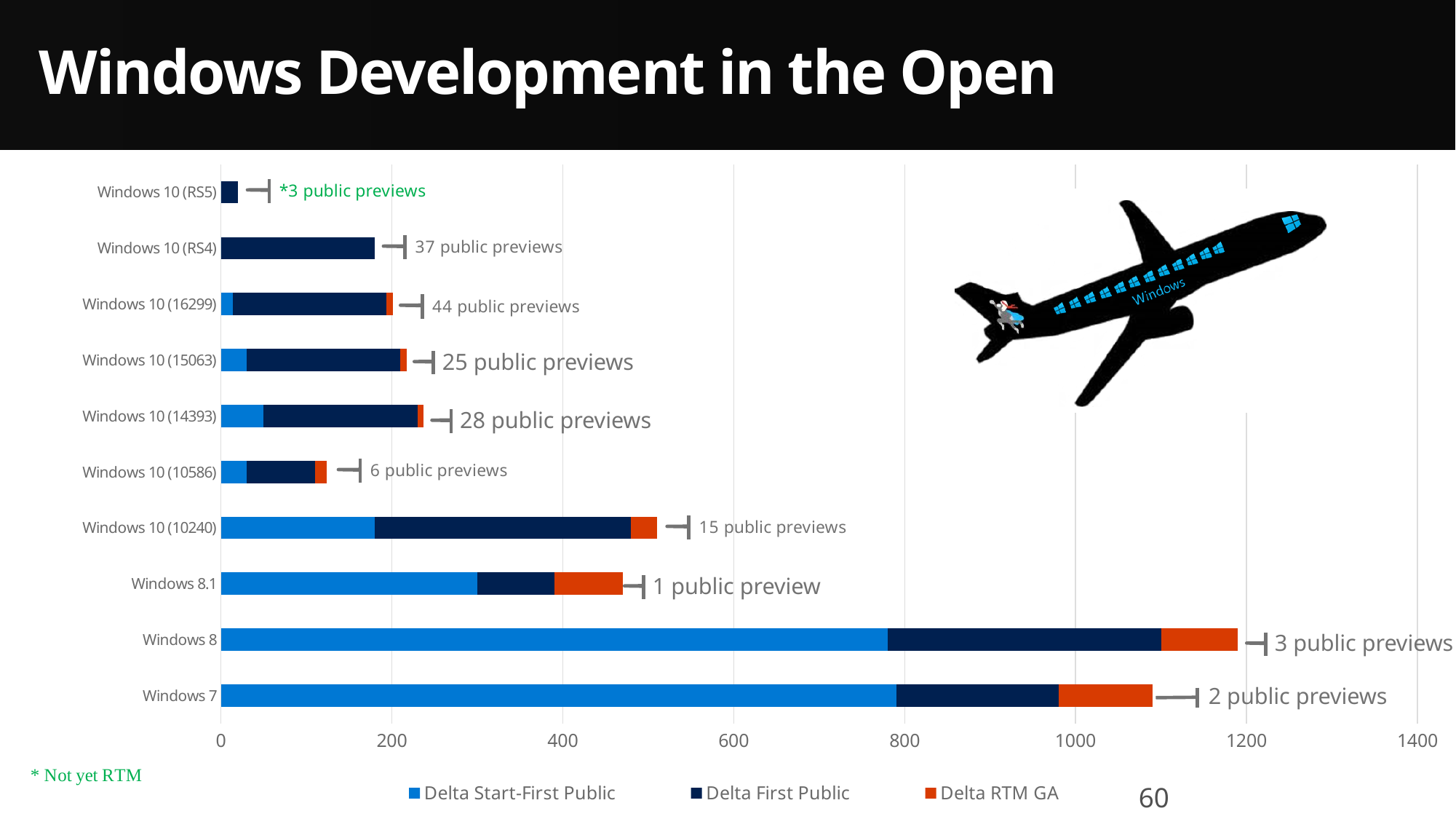
What kind of chart is shown on the slide? bar chart Is the total bar length for Windows 10 (10240) greater or less than 600? less What are the three series named in the legend? Delta Start-First Public, Delta First Public, Delta RTM GA Which Windows version has the shortest total bar? Windows 10 (RS5) How many public previews are noted for Windows 10 (RS4)? 37 public previews How many series does the legend list? 3 Is the total bar length for Windows 7 greater or less than 1000? greater How many public previews are noted for Windows 10 (16299)? 44 public previews Which Windows version has the longest total bar? Windows 8 How many public previews are noted for Windows 8.1? 1 public preview How many Windows versions (categories) are plotted on the chart? 10 Which has a longer total bar, Windows 8.1 or Windows 10 (14393)? Windows 8.1